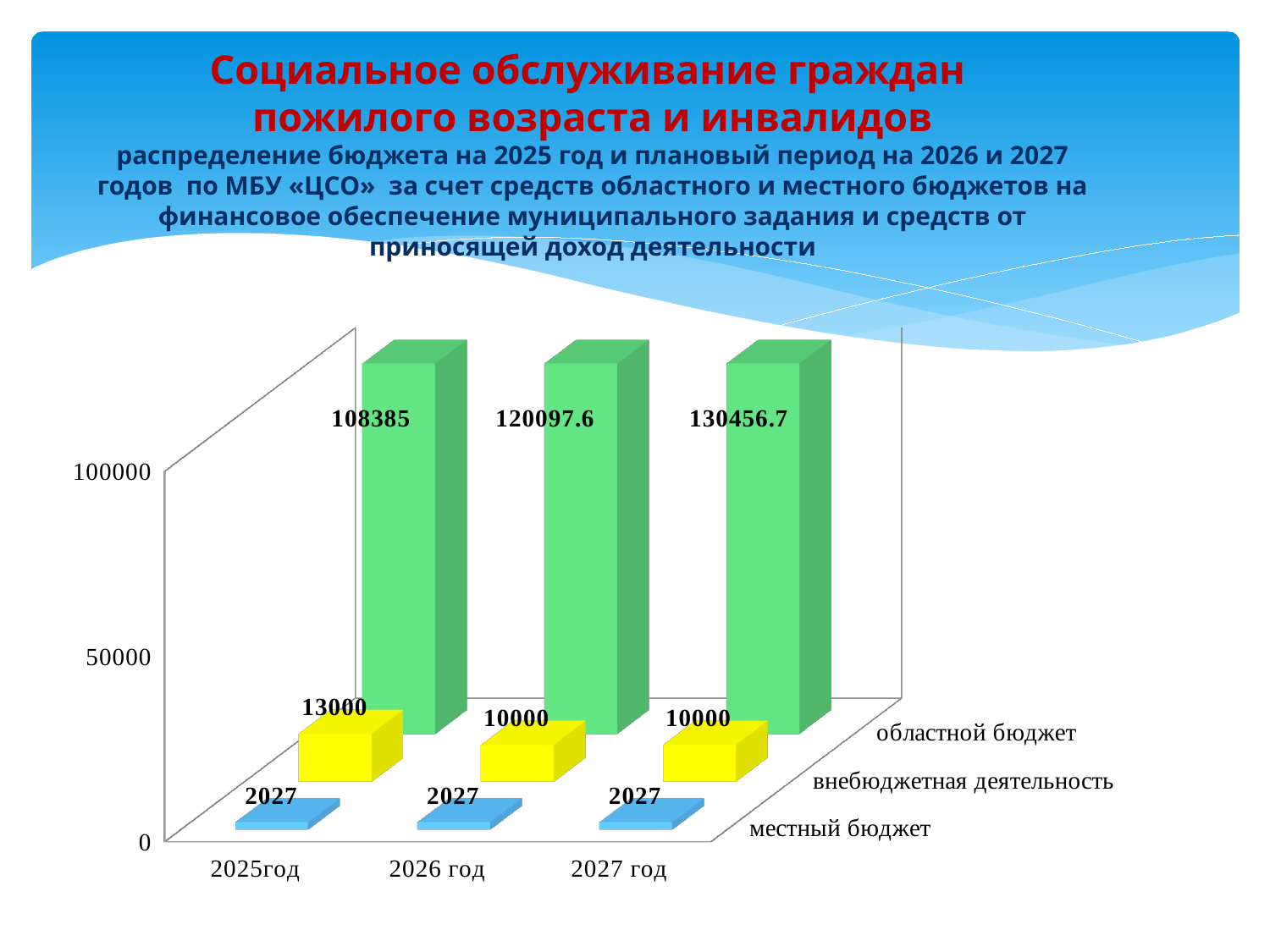
In which year is the областной бюджет value highest? 2027 год What is the value for местный бюджет in 2026 год? 2027 Is the value for областной бюджет in 2025год greater or less than 100000? greater What is the difference between the областной бюджет values for 2026 год and 2025год? 11712.6 How many years are shown on the x axis? 3 Which is larger: внебюджетная деятельность in 2025год or in 2027 год? 2025год What is the value for областной бюджет in 2027 год? 130456.7 In which year is the внебюджетная деятельность value highest? 2025год What is the value for областной бюджет in 2025год? 108385 What kind of chart is shown on the slide? bar chart What is the value for внебюджетная деятельность in 2025год? 13000 Do the областной бюджет values rise or fall from 2025год to 2027 год? rise